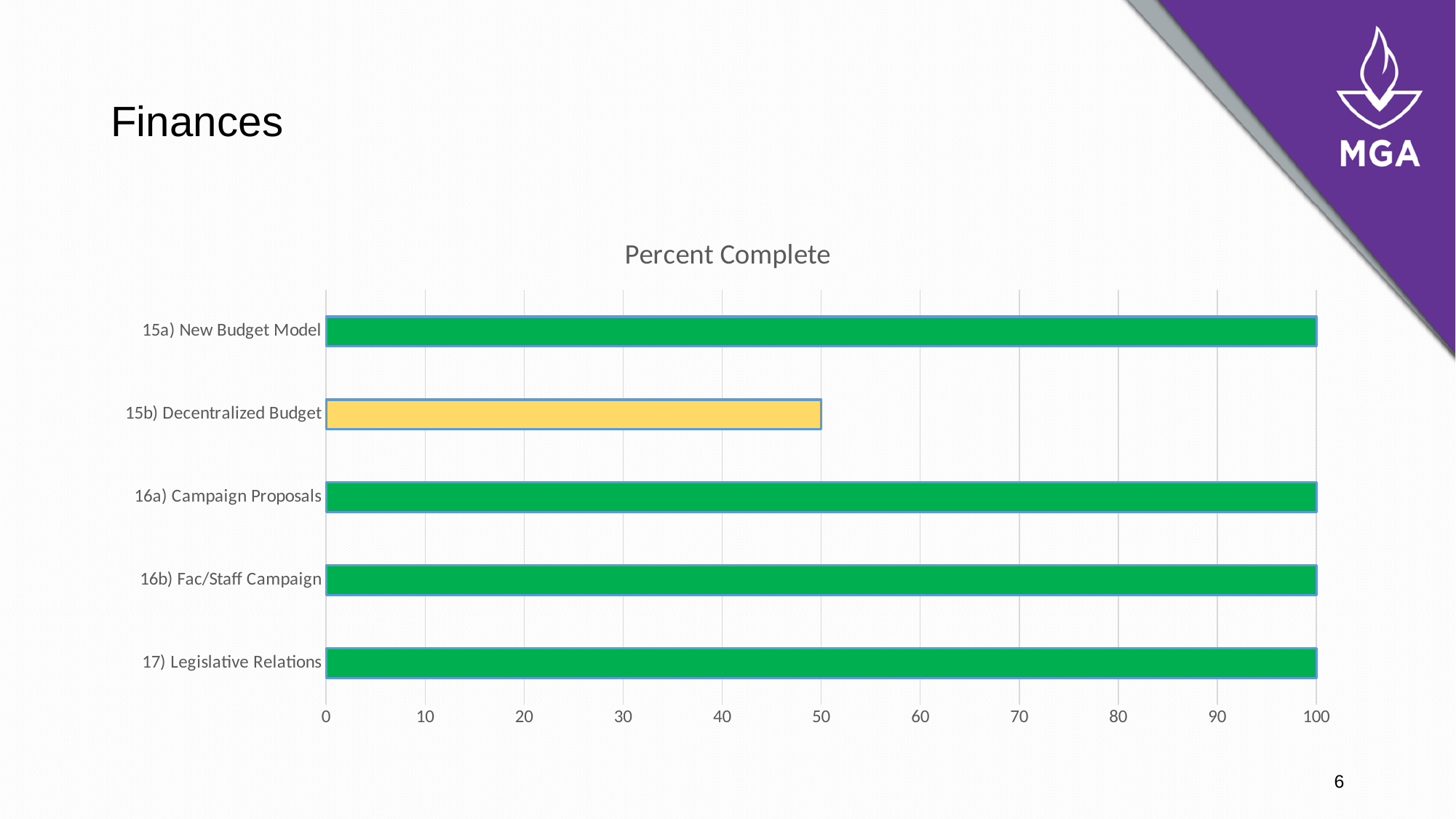
Which is larger, the value for 16a) Campaign Proposals or the value for 15b) Decentralized Budget? 16a) Campaign Proposals Which category has the lowest value? 15b) Decentralized Budget What is the title of the chart? Percent Complete What is the difference between the value for 16b) Fac/Staff Campaign and the value for 15b) Decentralized Budget? 50 How many categories are plotted in the chart? 5 What kind of chart is shown on the slide? bar chart Is the value for 15b) Decentralized Budget greater or less than 80? less Which category's bar is coloured differently from the others? 15b) Decentralized Budget What is the value for 17) Legislative Relations? 100 What is the value for 15a) New Budget Model? 100 What is the value for 15b) Decentralized Budget? 50 How many categories have a value of 100? 4